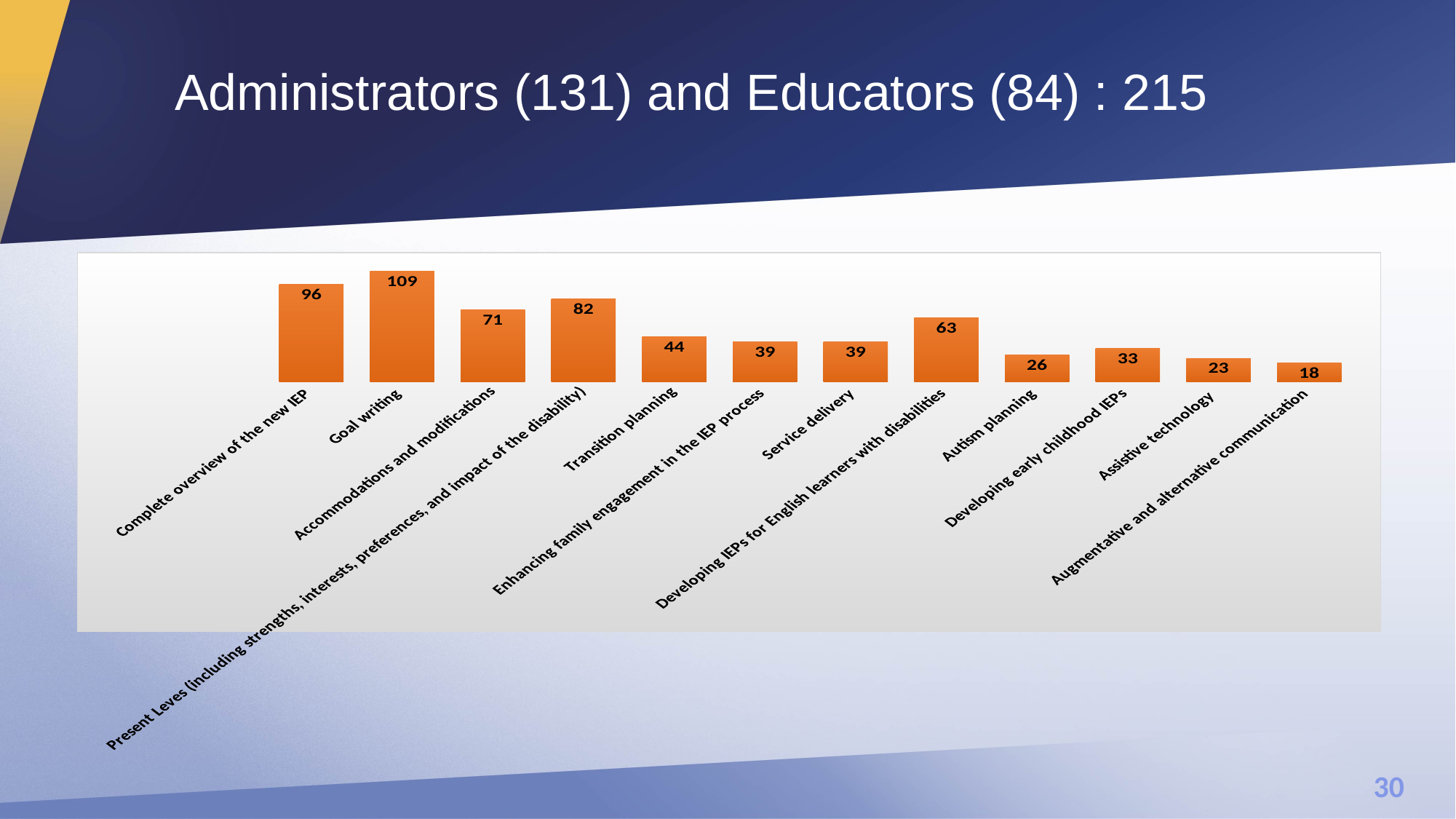
How many categories are shown in the chart? 12 What colour are the bars in the chart? Orange What kind of chart is shown on the slide? Bar chart Which category has the highest value? Goal writing What is the difference between the values for Accommodations and modifications and Autism planning? 45 What is the value for Goal writing? 109 What is the value for Developing IEPs for English learners with disabilities? 63 What is the value for Transition planning? 44 What is the difference between the values for Goal writing and Complete overview of the new IEP? 13 What is the value for Assistive technology? 23 Which is larger, the value for Developing early childhood IEPs or the value for Autism planning? Developing early childhood IEPs Which category has the lowest value? Augmentative and alternative communication